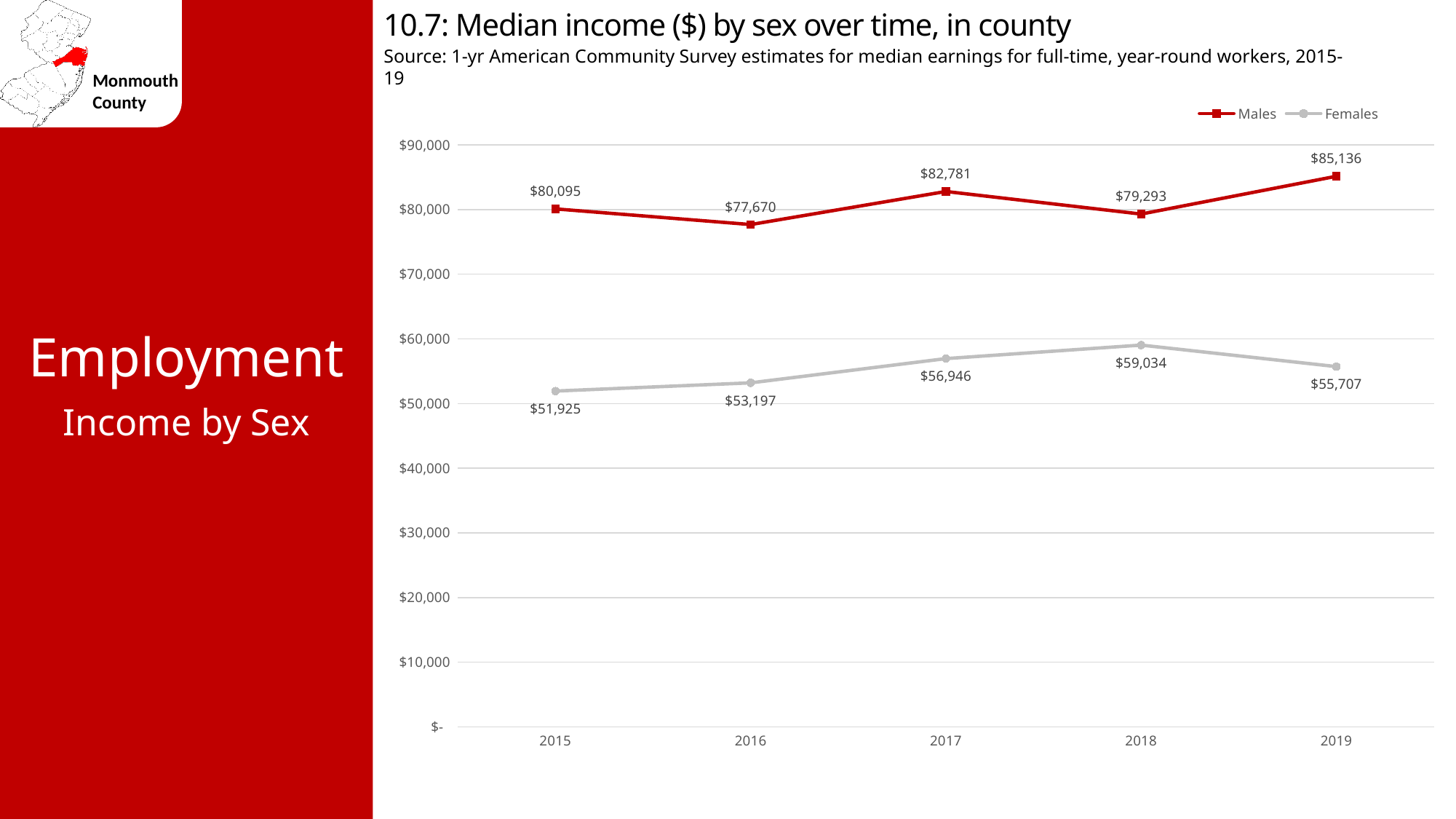
How many series does the legend list? 2 What was the median income for Males in 2016? $77,670 What was the median income for Males in 2019? $85,136 In which year was the median income for Males lowest? 2016 In which year was the median income for Females highest? 2018 What colour is the line for Males? Red How many years are plotted on the x axis? 5 Which was higher in 2018: the median income for Males or for Females? Males What kind of chart is shown on the slide? Line chart Did the median income for Females rise or fall from 2015 to 2018? Rise What was the median income for Females in 2015? $51,925 What is the difference between the Males and Females median income in 2017? $25,835